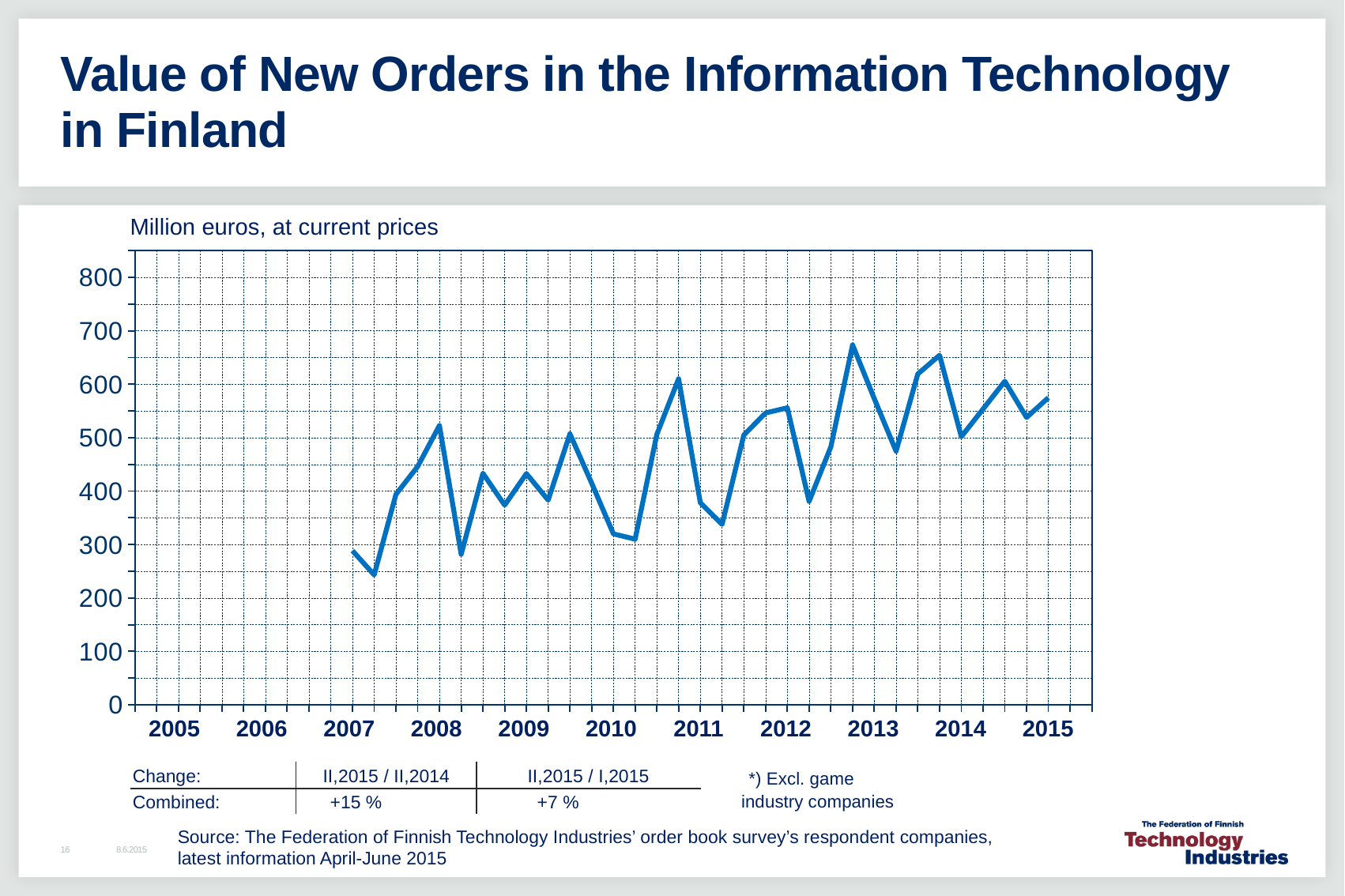
What is the combined change for II,2015 / I,2015 shown below the chart? +7 % Is the highest point of the line greater or less than 600? greater Overall, does the value of new orders rise or fall from 2007 to 2015? rise Is the highest point of the line greater or less than 700? less Is the last plotted value, in 2015, greater or less than 500? greater How many year labels are shown on the x axis of the chart? 11 How many lines are plotted on the chart? 1 What unit is the y axis of the chart measured in, according to the label above the chart? Million euros, at current prices In which year does the line reach its lowest value? 2007 What is the combined change for II,2015 / II,2014 shown below the chart? +15 % What kind of chart is shown on the slide? Line chart